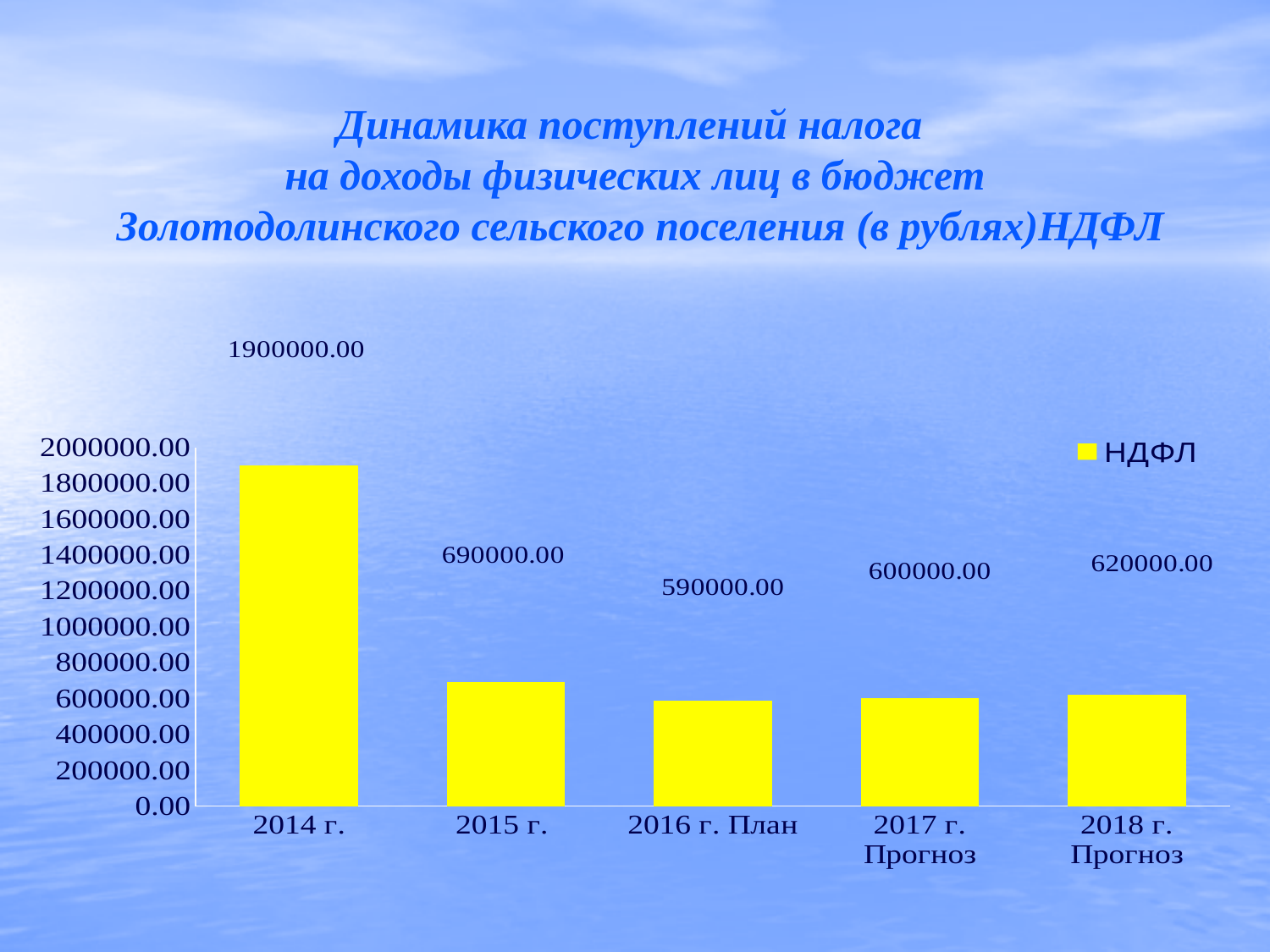
What is the difference between the values for 2014 г. and 2015 г.? 1210000.00 Is the value for 2015 г. greater or less than 1000000.00? less Which is larger, the value for 2015 г. or the value for 2017 г. Прогноз? 2015 г. What is the value for 2014 г.? 1900000.00 What is the difference between the values for 2018 г. Прогноз and 2017 г. Прогноз? 20000.00 How many categories are shown on the x axis? 5 Which category has the lowest value? 2016 г. План What kind of chart is shown on the slide? bar chart What is the value for 2018 г. Прогноз? 620000.00 What is the value for 2016 г. План? 590000.00 Which category has the highest value? 2014 г. How many series does the legend list? 1